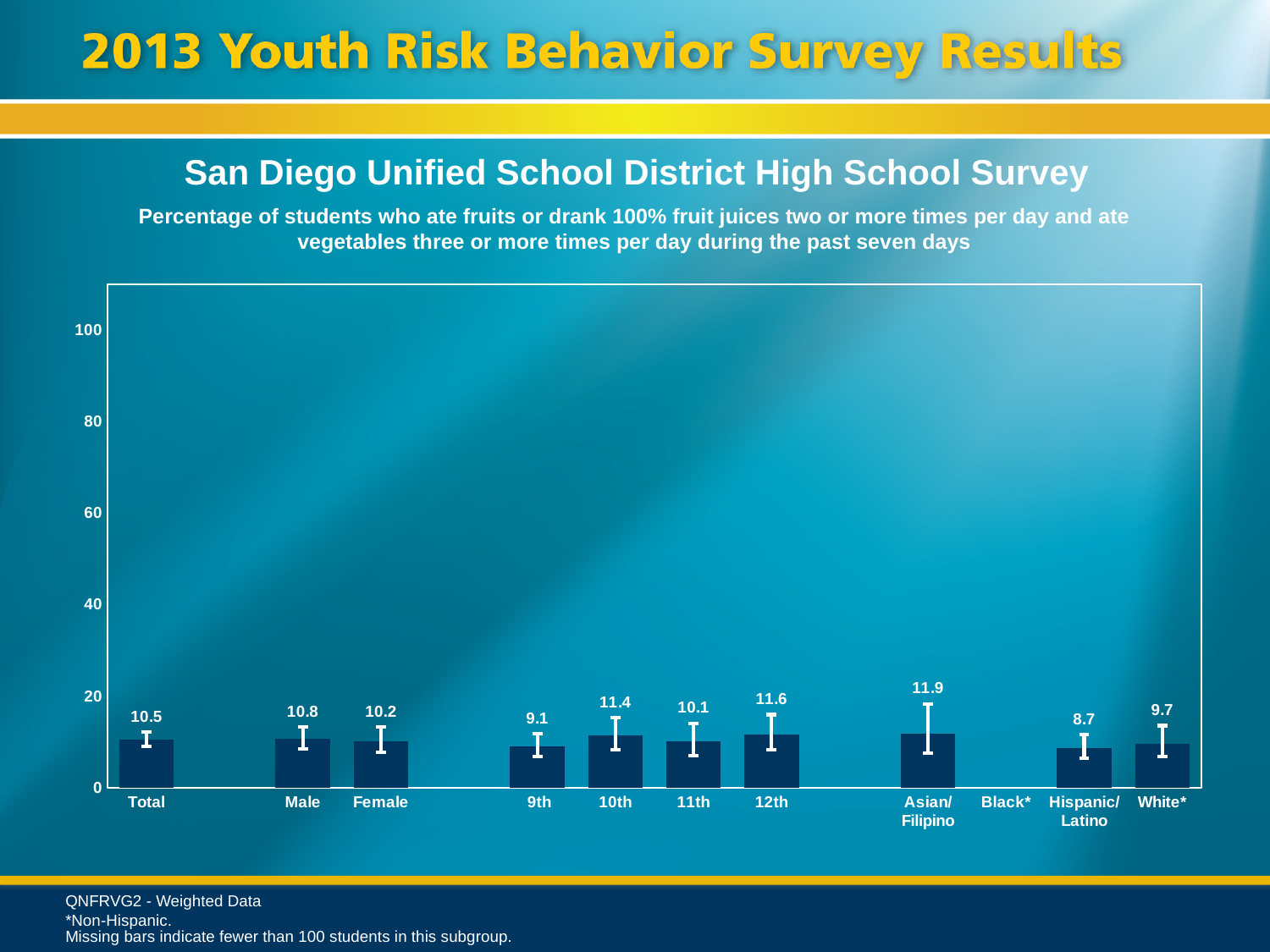
Which category has the lowest value among the bars shown? Hispanic/Latino What is the difference between the values for Male and Female? 0.6 What is the value for Total? 10.5 Which is larger, the value for 10th or the value for 11th? 10th What kind of chart is this? bar chart What is the value for 12th? 11.6 What is the value for Hispanic/Latino? 8.7 Which category has the highest value? Asian/Filipino Which category has no bar shown? Black* Is the value for White* greater or less than 20? less How many categories have a bar plotted? 10 What is the value for Female? 10.2